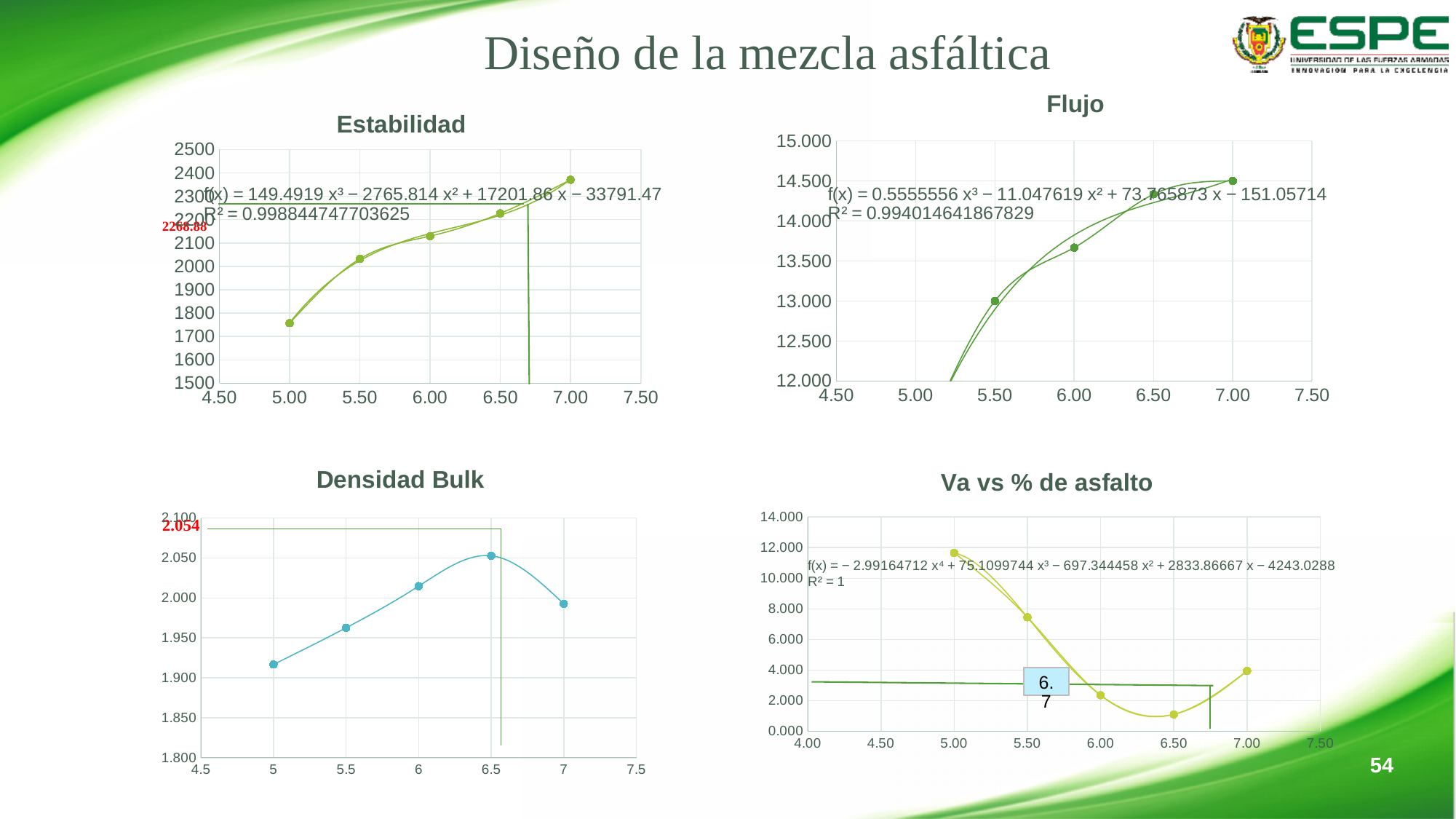
In the Estabilidad chart, at which x value is the plotted value highest? 7.00 In the Flujo chart, do the plotted values rise or fall as x increases? rise In the Va vs % de asfalto chart, at which x value is the plotted value lowest? 6.50 In the Densidad Bulk chart, is the value at 5 greater or less than 1.950? less In the Estabilidad chart, at which x value is the plotted value lowest? 5.00 In the Densidad Bulk chart, at which x value is the plotted value highest? 6.5 In the Flujo chart, is the value at 5.50 greater or less than 13.500? less In the Estabilidad chart, how many data points are plotted? 5 In the Estabilidad chart, is the value at 5.00 greater or less than 2000? less How many charts are shown on the slide? 4 In the Va vs % de asfalto chart, what R² value is shown? R² = 1